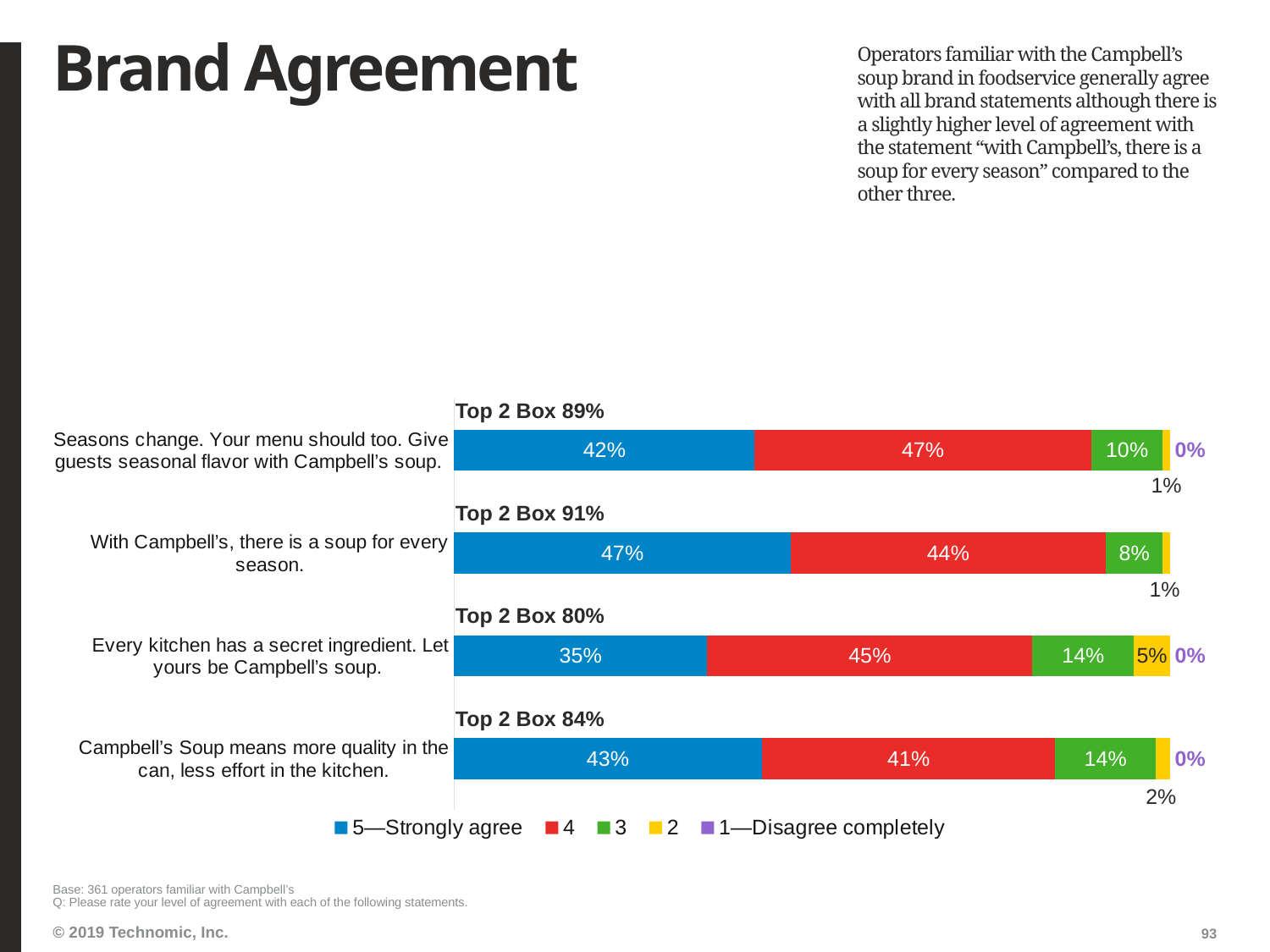
Which statement has the lowest share of operators who strongly agree (rating 5)? Every kitchen has a secret ingredient. Let yours be Campbell's soup. Which statement has the highest share of operators who strongly agree (rating 5)? With Campbell's, there is a soup for every season. What percentage gave a rating of 2 to the statement "Every kitchen has a secret ingredient. Let yours be Campbell's soup"? 5% Which statement has a larger share of rating 4 responses: "Seasons change. Your menu should too. Give guests seasonal flavor with Campbell's soup" or "Campbell's Soup means more quality in the can, less effort in the kitchen"? Seasons change. Your menu should too. Give guests seasonal flavor with Campbell's soup. How many series does the chart legend list? 5 What is the difference in the strongly agree (rating 5) percentage between "With Campbell's, there is a soup for every season" and "Every kitchen has a secret ingredient. Let yours be Campbell's soup"? 12% What percentage gave a rating of 4 to the statement "Every kitchen has a secret ingredient. Let yours be Campbell's soup"? 45% What percentage of operators strongly agree (rating 5) with the statement "With Campbell's, there is a soup for every season"? 47% What is the Top 2 Box score for the statement "Every kitchen has a secret ingredient. Let yours be Campbell's soup"? 80% What percentage gave a rating of 3 to the statement "Campbell's Soup means more quality in the can, less effort in the kitchen"? 14% How many brand statements are shown in the chart? 4 What type of chart is shown on the slide? Stacked bar chart